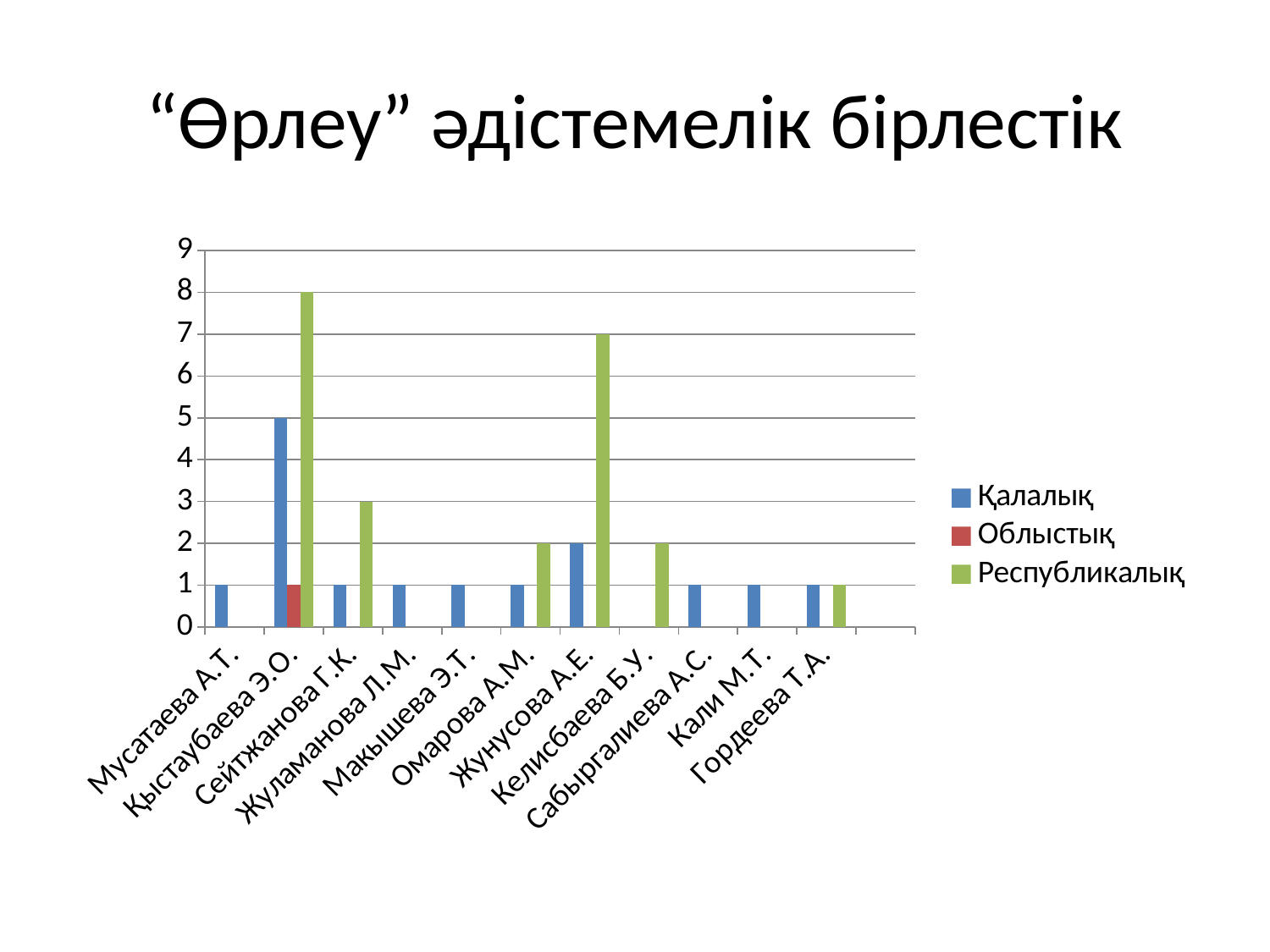
What kind of chart is shown on the slide? bar chart What is the Қалалық value for Қыстаубаева Э.О.? 5 How many series does the legend list? 3 What is the difference between the Республикалық values for Қыстаубаева Э.О. and Жунусова А.Е.? 1 How many categories (names) are shown on the x axis? 11 Which category has the highest Қалалық value? Қыстаубаева Э.О. What is the Республикалық value for Сейтжанова Г.К.? 3 What is the Республикалық value for Жунусова А.Е.? 7 Which category has the highest Республикалық value? Қыстаубаева Э.О. Which category is the only one with an Облыстық bar? Қыстаубаева Э.О. Which is larger: the Республикалық value for Сейтжанова Г.К. or the Республикалық value for Омарова А.М.? Сейтжанова Г.К. What is the Республикалық value for Қыстаубаева Э.О.? 8